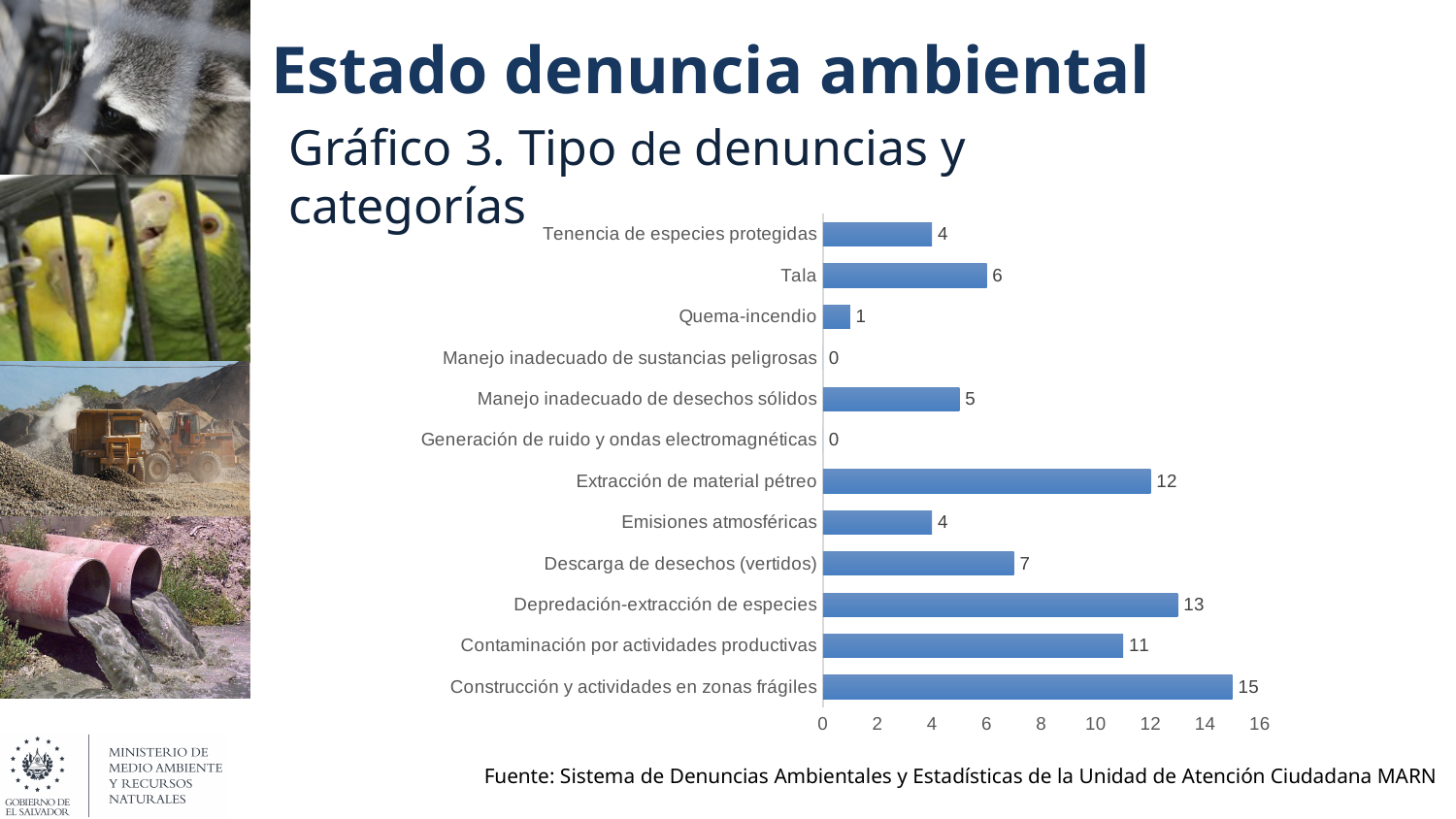
What is the value for Extracción de material pétreo? 12 What is the value for Construcción y actividades en zonas frágiles? 15 What kind of chart is shown on the slide? Bar chart What is the difference between Depredación-extracción de especies and Contaminación por actividades productivas? 2 Which categories have a value of 0? Manejo inadecuado de sustancias peligrosas and Generación de ruido y ondas electromagnéticas What is the value for Tala? 6 Is the value for Extracción de material pétreo greater or less than 10? greater Which category has the highest value? Construcción y actividades en zonas frágiles What is the title of the chart? Gráfico 3. Tipo de denuncias y categorías Which is larger, Descarga de desechos (vertidos) or Emisiones atmosféricas? Descarga de desechos (vertidos) How many categories are shown in the chart? 12 What is the maximum value shown on the horizontal axis? 16